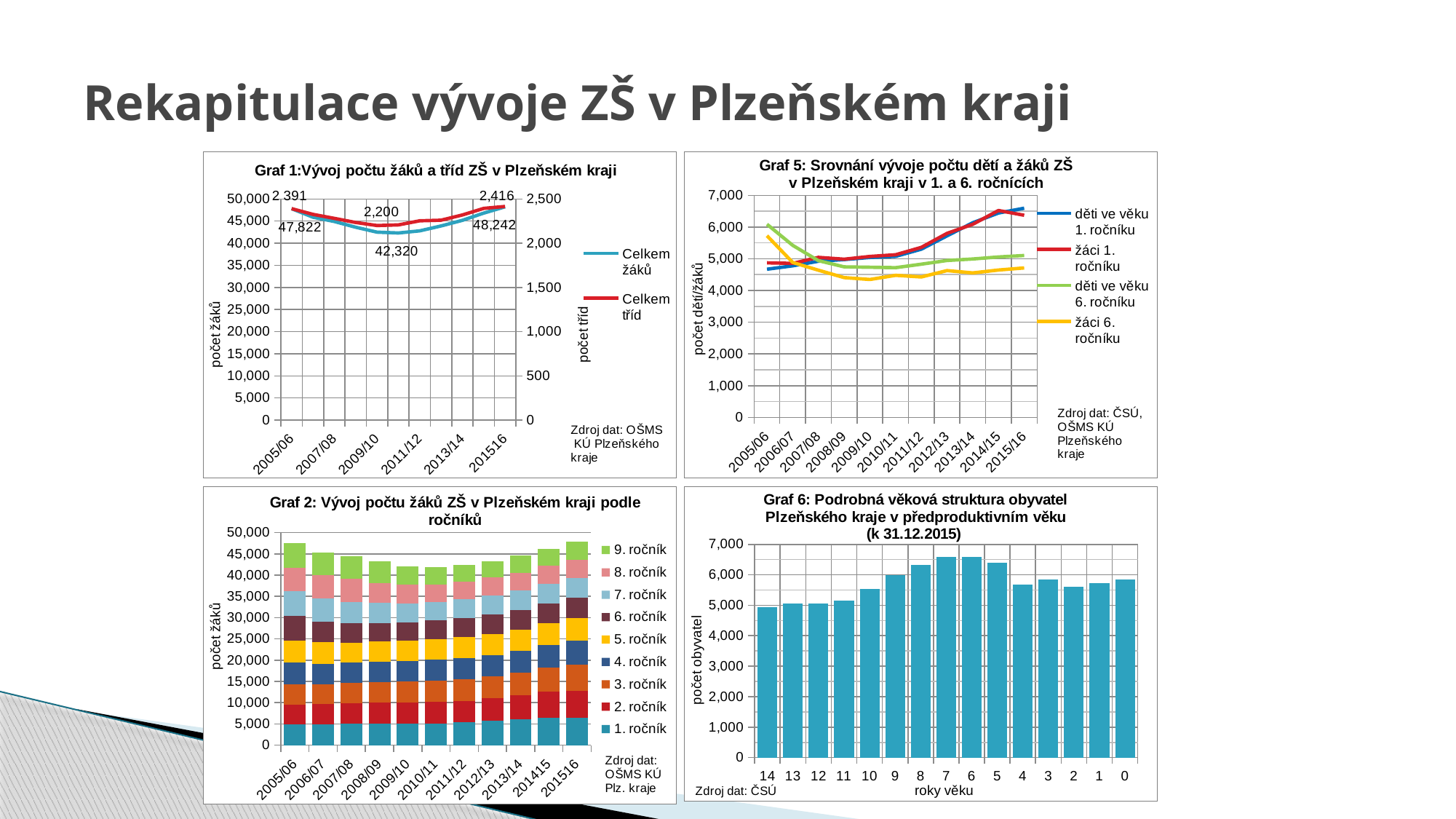
What kind of chart is Graf 6? bar chart In Graf 1, what is the difference between the Celkem žáků values for 2015/16 and 2005/06? 420 What kind of chart is Graf 5? line chart How many age categories are shown on the x axis of Graf 6? 15 In Graf 1, what is the value of Celkem žáků for 2005/06? 47,822 How many series does the legend of Graf 2 list? 9 In Graf 1, what is the value of Celkem tříd for 2009/10? 2,200 In Graf 6, is the value for age 7 greater or less than 6,000? greater In Graf 1, which is larger, the Celkem žáků value for 2015/16 or for 2005/06? 2015/16 In Graf 1, what is the difference between the Celkem tříd values for 2015/16 and 2005/06? 25 How many school years are shown on the x axis of Graf 2? 11 How many series does the legend of Graf 5 list? 4